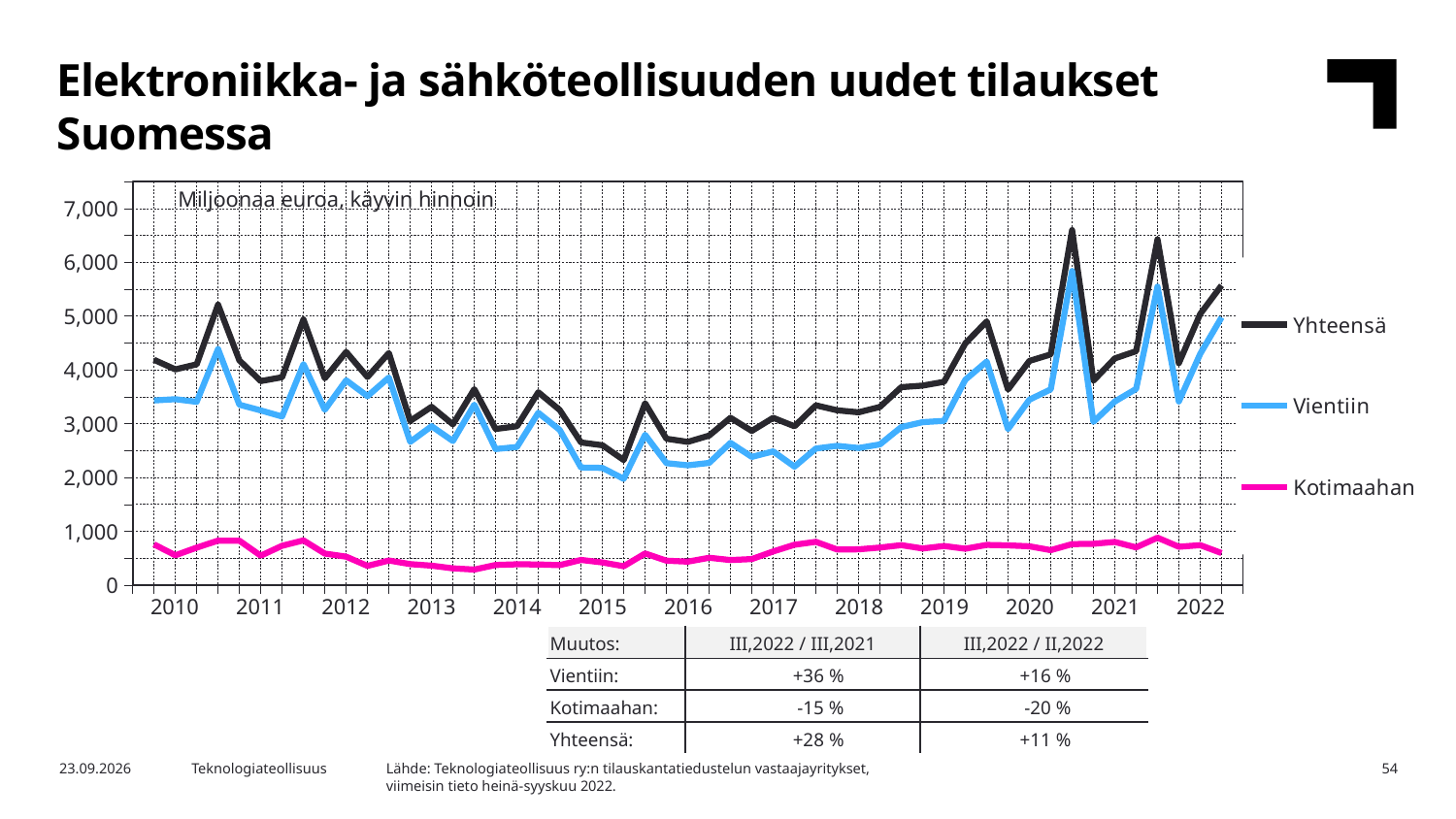
What unit label is printed inside the chart area? Miljoonaa euroa, käyvin hinnoin What are the three series named in the legend? Yhteensä, Vientiin, Kotimaahan Is the value for Vientiin at the start of 2015 greater or less than 3,000? less Which series has the highest values throughout the chart? Yhteensä What kind of chart is shown on the slide? line chart Is the value for Kotimaahan in 2010 greater or less than 1,000? less Which series has the lowest values throughout the chart? Kotimaahan How many series does the legend list? 3 Is the peak value for Yhteensä in 2020 greater or less than 6,000? greater Does the Yhteensä line generally rise or fall from 2016 to 2022? rise Which series is larger in 2018, Vientiin or Kotimaahan? Vientiin How many year labels are shown on the x axis? 13